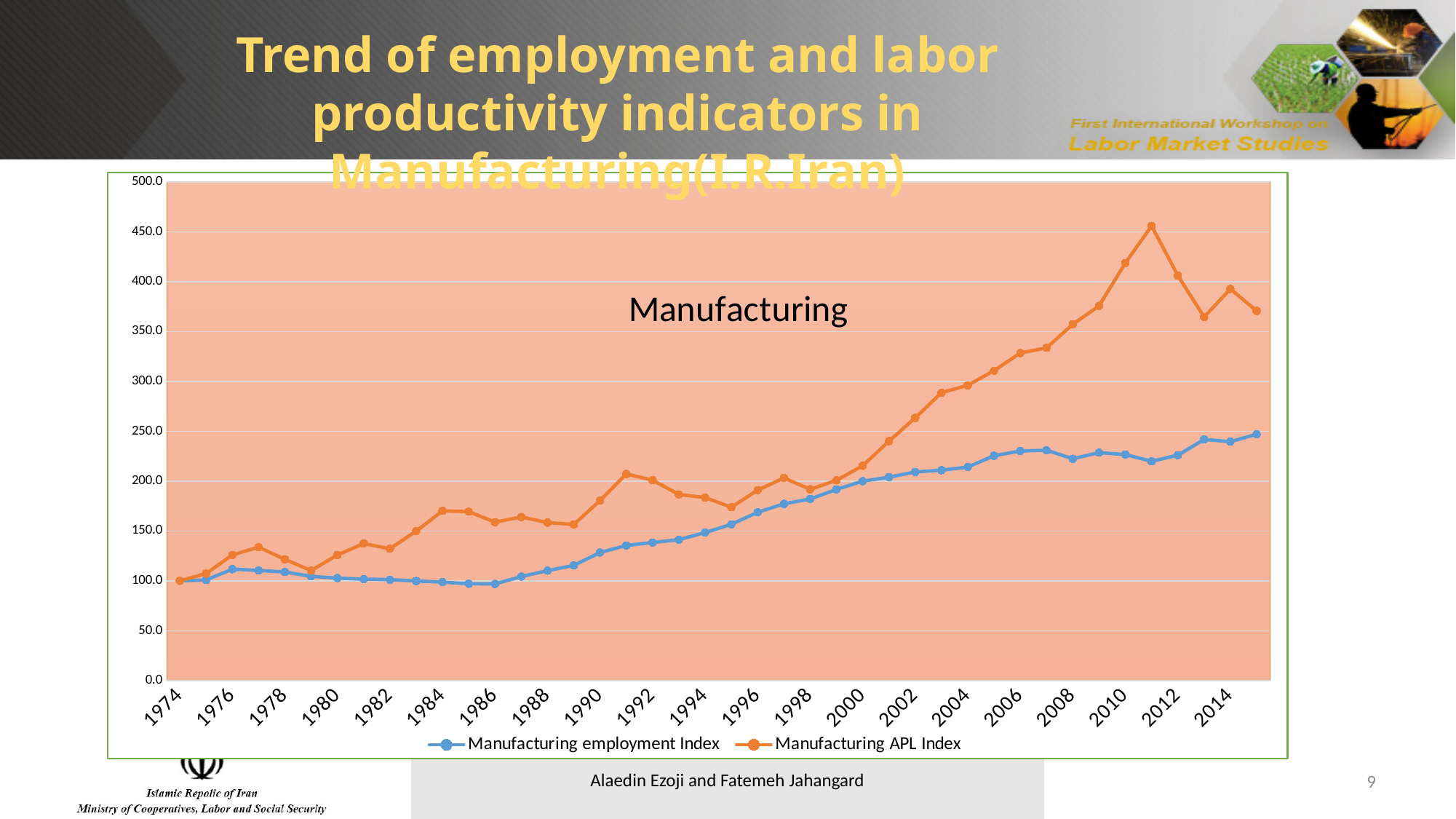
How many series does the chart legend list? 2 Is the Manufacturing employment Index in 1980 greater or less than 150? less In 2010, which series has the higher value: Manufacturing employment Index or Manufacturing APL Index? Manufacturing APL Index What kind of chart is shown on the slide? line chart What title is printed inside the chart's plot area? Manufacturing Is the Manufacturing employment Index in 2014 greater or less than 200? greater In which year does the Manufacturing APL Index reach its highest value? 2011 What are the two series named in the chart legend? Manufacturing employment Index and Manufacturing APL Index What is the value of the Manufacturing APL Index in 1974? 100.0 How many year labels are shown on the x axis? 21 Does the Manufacturing employment Index generally rise or fall between 1990 and 2014? rise Is the Manufacturing APL Index in 2011 greater or less than 400? greater